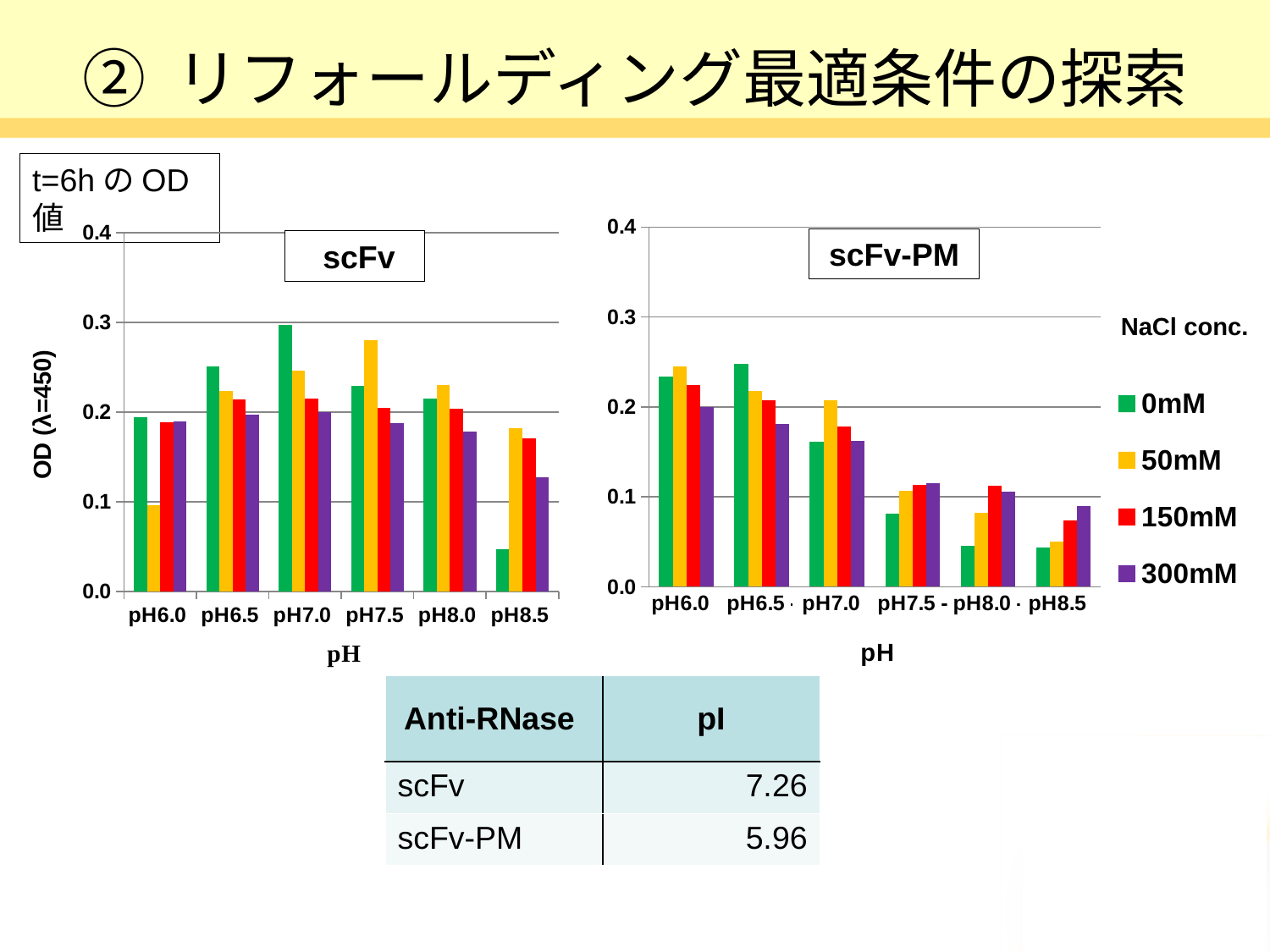
In the scFv-PM chart, do the 0mM values rise or fall from pH6.5 to pH8.5? fall In the scFv chart, at which pH is the 0mM bar highest? pH7.0 In the scFv chart, is the value for 50mM at pH7.5 greater or less than 0.2? greater What is the title of the legend shared by the two charts? NaCl conc. In the scFv-PM chart, is the value for 0mM at pH7.5 greater or less than 0.1? less In the scFv chart, at which pH is the 0mM bar lowest? pH8.5 In the scFv-PM chart, is the value for 150mM at pH6.0 greater or less than 0.2? greater In the scFv-PM chart, which is larger: the 0mM bar at pH6.0 or the 0mM bar at pH8.5? pH6.0 How many pH categories are shown on the x axis of the scFv-PM chart? 6 What kind of chart is the scFv chart? bar chart How many series does the legend list for the charts? 4